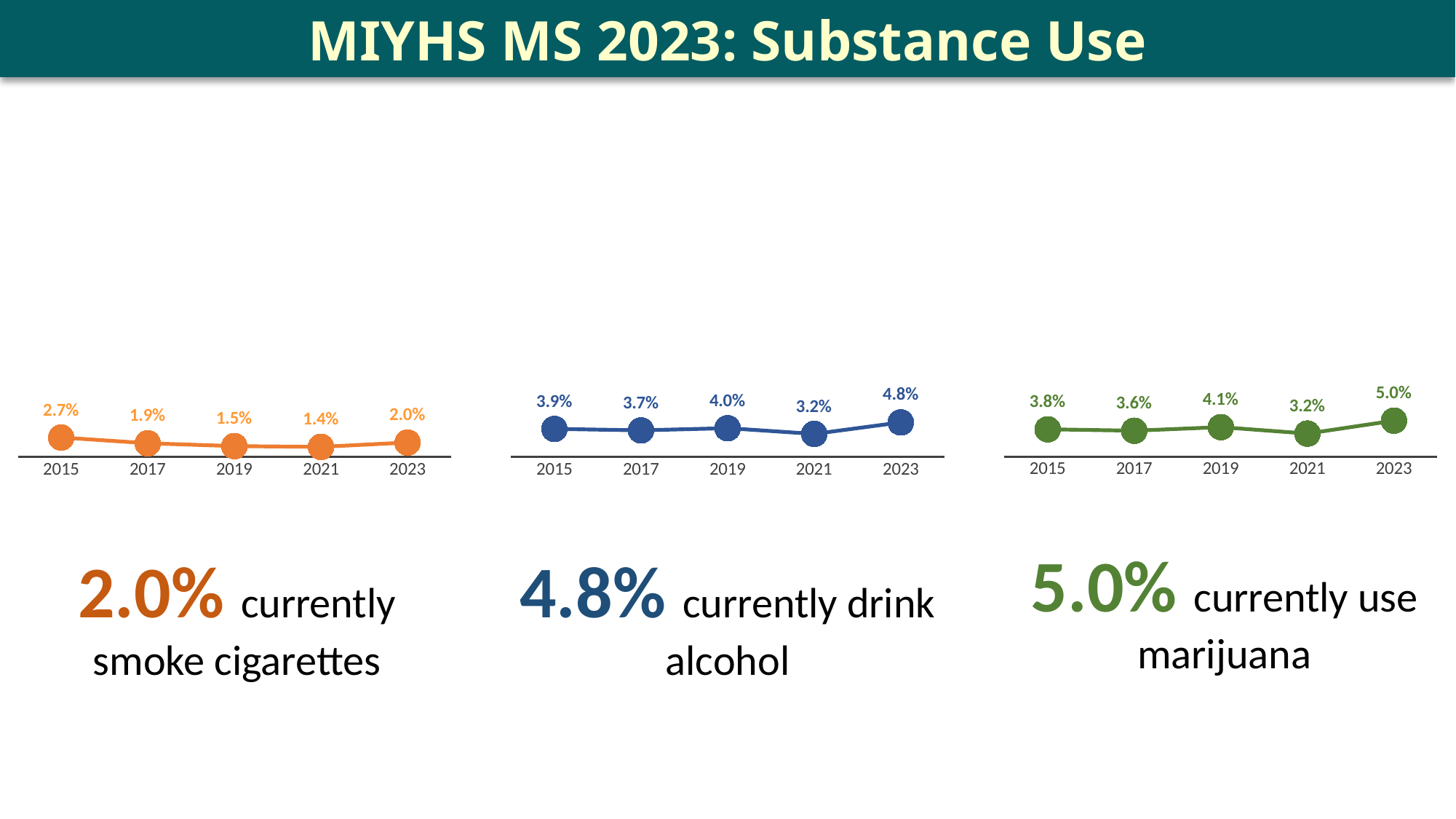
How many data points are plotted in the left chart (cigarette smoking)? 5 In the right chart (marijuana), is the value for 2023 larger or smaller than the value for 2019? larger In the middle chart (alcohol), what is the value for 2019? 4.0% In the right chart (marijuana), what is the value for 2017? 3.6% In the left chart (cigarette smoking), which year has the lowest value? 2021 In the middle chart (alcohol), what is the difference between the 2023 and 2021 values? 1.6% What type of chart is the middle chart (alcohol)? line chart In the middle chart (alcohol), which year has the highest value? 2023 In the left chart (cigarette smoking), what is the value for 2015? 2.7% In the left chart (cigarette smoking), what is the difference between the 2015 and 2023 values? 0.7% In the right chart (marijuana), do the values rise or fall from 2021 to 2023? rise In the right chart (marijuana), which year has the lowest value? 2021